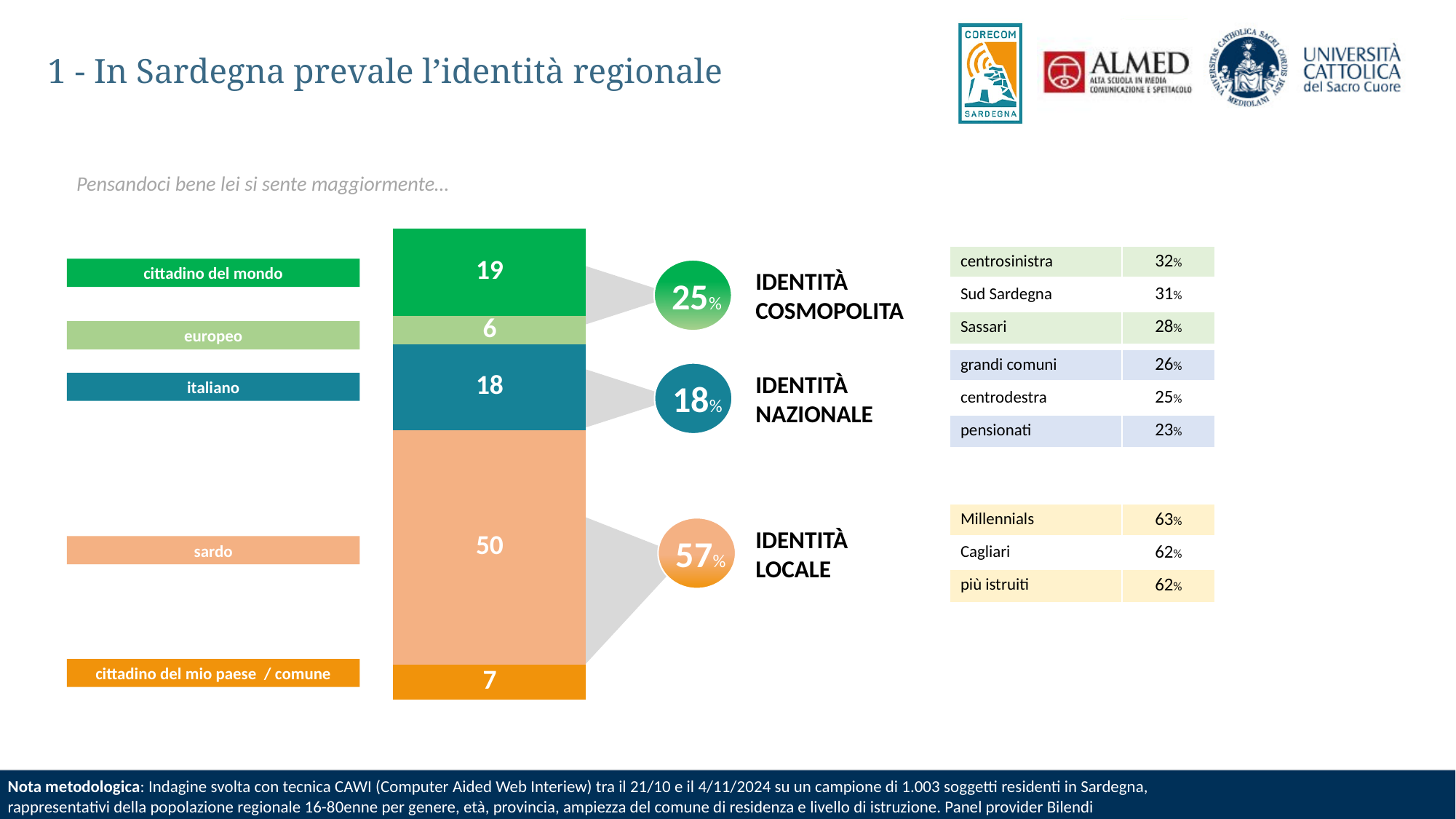
Which segment of the stacked bar has the lowest value? europeo What value is shown for the 'cittadino del mondo' segment of the stacked bar? 19 Which segment of the stacked bar has the highest value? sardo What kind of chart is used to show the identity responses? stacked bar chart What is the total of all segments in the stacked bar? 100 What value is shown for the 'sardo' segment of the stacked bar? 50 What percentage is shown in the circle for 'IDENTITÀ LOCALE'? 57% Which is larger, the value for 'cittadino del mondo' or the value for 'italiano'? cittadino del mondo How many segments make up the stacked bar? 5 What value is shown for the 'europeo' segment of the stacked bar? 6 What value is shown for the 'cittadino del mio paese / comune' segment? 7 What is the difference between the 'sardo' value and the 'italiano' value? 32